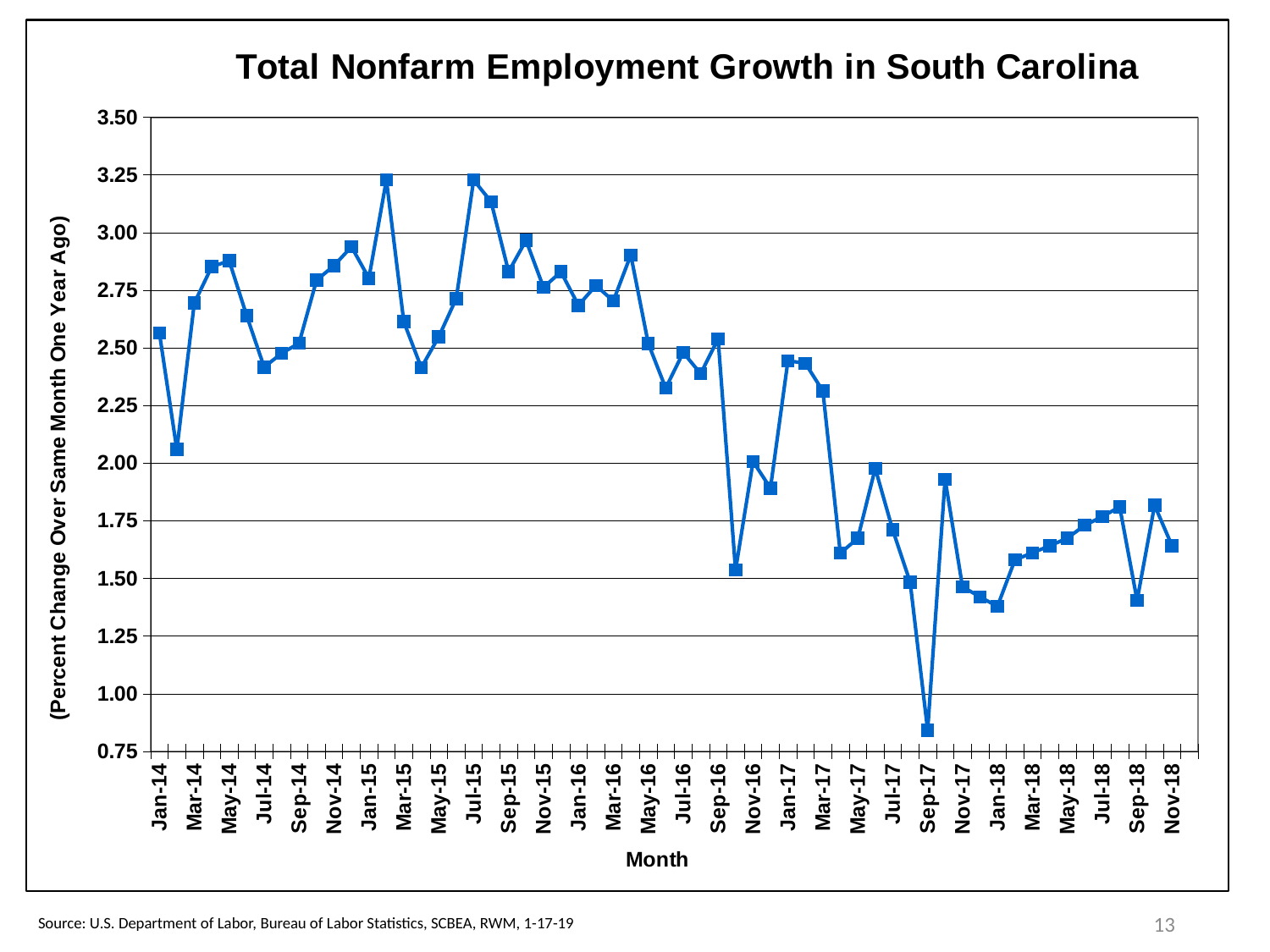
Is the value for Jan-17 greater or less than 2.50? less What is the label on the vertical axis of the chart? (Percent Change Over Same Month One Year Ago) Which month has the lowest value on the chart? Sep-17 Which is higher, the value for Sep-17 or the value for Sep-18? Sep-18 What kind of chart is shown on the slide? line chart What is the title of the chart? Total Nonfarm Employment Growth in South Carolina Is the value for Jan-18 greater or less than 1.50? less Is the value for Nov-18 greater or less than 1.50? greater Overall, do the values rise or fall from Jan-14 to Nov-18? fall Which is higher, the value for Jan-14 or the value for Jan-18? Jan-14